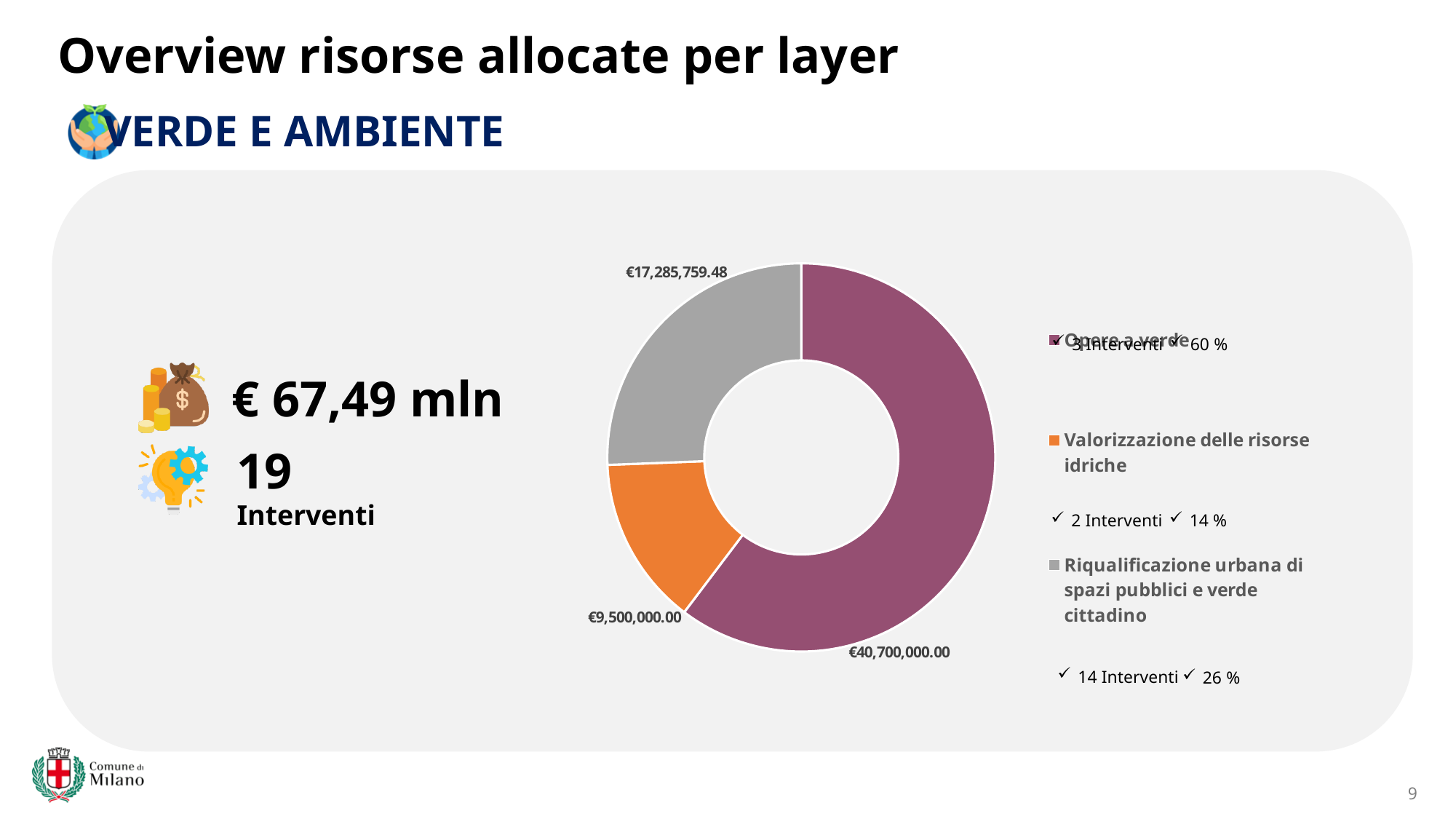
What is the value of the slice for Riqualificazione urbana di spazi pubblici e verde cittadino? €17,285,759.48 What is the difference between the Opere a verde slice and the Valorizzazione delle risorse idriche slice? €31,200,000.00 What is the value of the slice for Valorizzazione delle risorse idriche? €9,500,000.00 Which category has the largest slice in the donut chart? Opere a verde What share of the donut chart does the Opere a verde slice represent, according to the slide? 60 % Which slice is larger: Riqualificazione urbana di spazi pubblici e verde cittadino or Valorizzazione delle risorse idriche? Riqualificazione urbana di spazi pubblici e verde cittadino What kind of chart is shown on the slide? Donut (pie) chart Which category has the smallest slice in the donut chart? Valorizzazione delle risorse idriche What is the difference between the Opere a verde slice and the Riqualificazione urbana di spazi pubblici e verde cittadino slice? €23,414,240.52 What colour is the slice for Valorizzazione delle risorse idriche? Orange What is the value of the largest slice in the donut chart? €40,700,000.00 How many slices does the donut chart have? 3